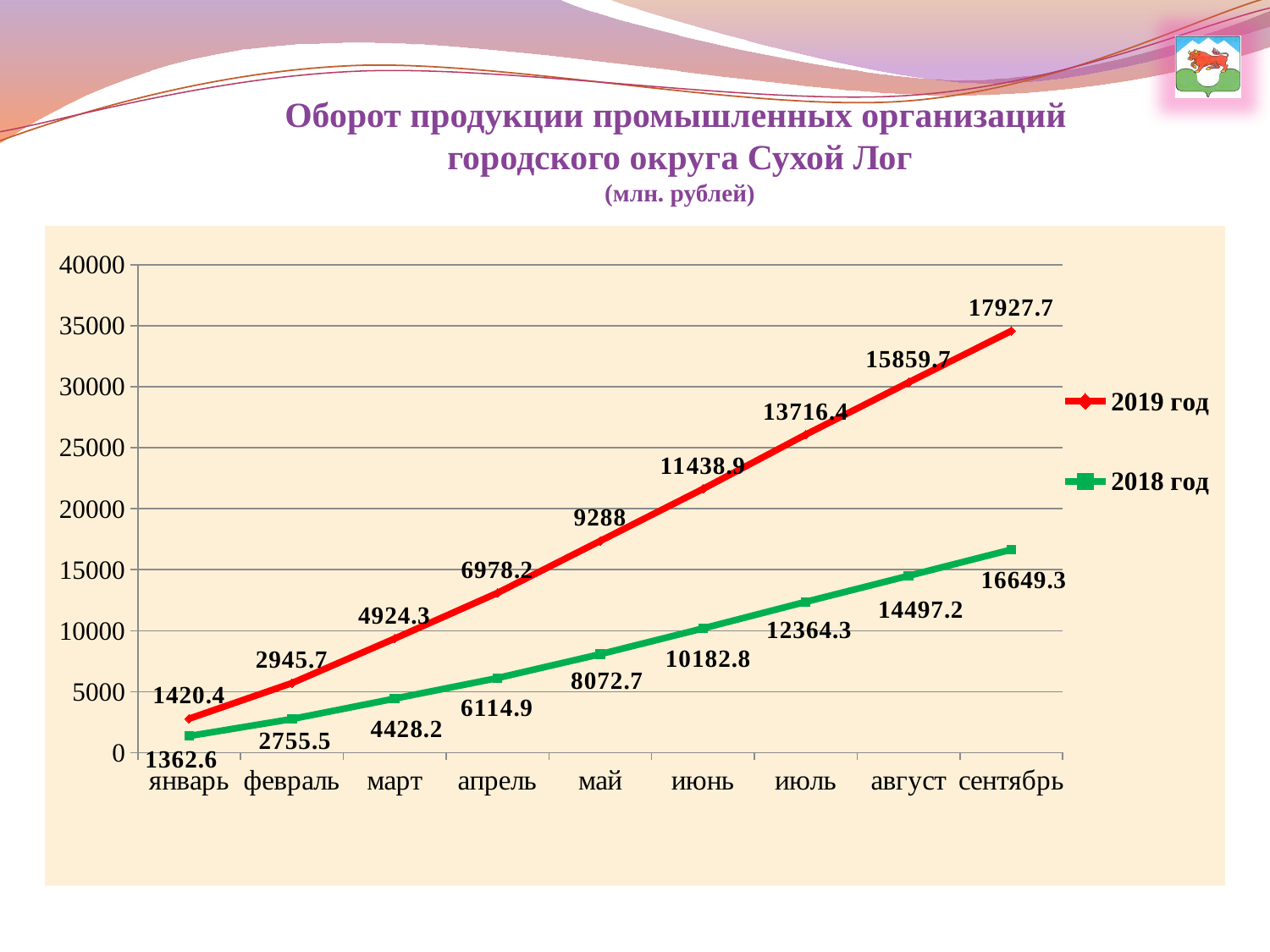
Which month has the lowest value in the 2018 год series? январь Do the values of the 2018 год series rise or fall from январь to сентябрь? rise What is the difference between the 2019 год and 2018 год values for сентябрь? 1278.4 What is the value for сентябрь in the 2018 год series? 16649.3 How many months are shown on the x axis? 9 What kind of chart is shown on the slide? line chart What is the value for январь in the 2019 год series? 1420.4 Which series has the larger value for июль, 2019 год or 2018 год? 2019 год Which month has the highest value in the 2019 год series? сентябрь What is the value for май in the 2019 год series? 9288 How many series does the legend list? 2 What is the value for апрель in the 2018 год series? 6114.9